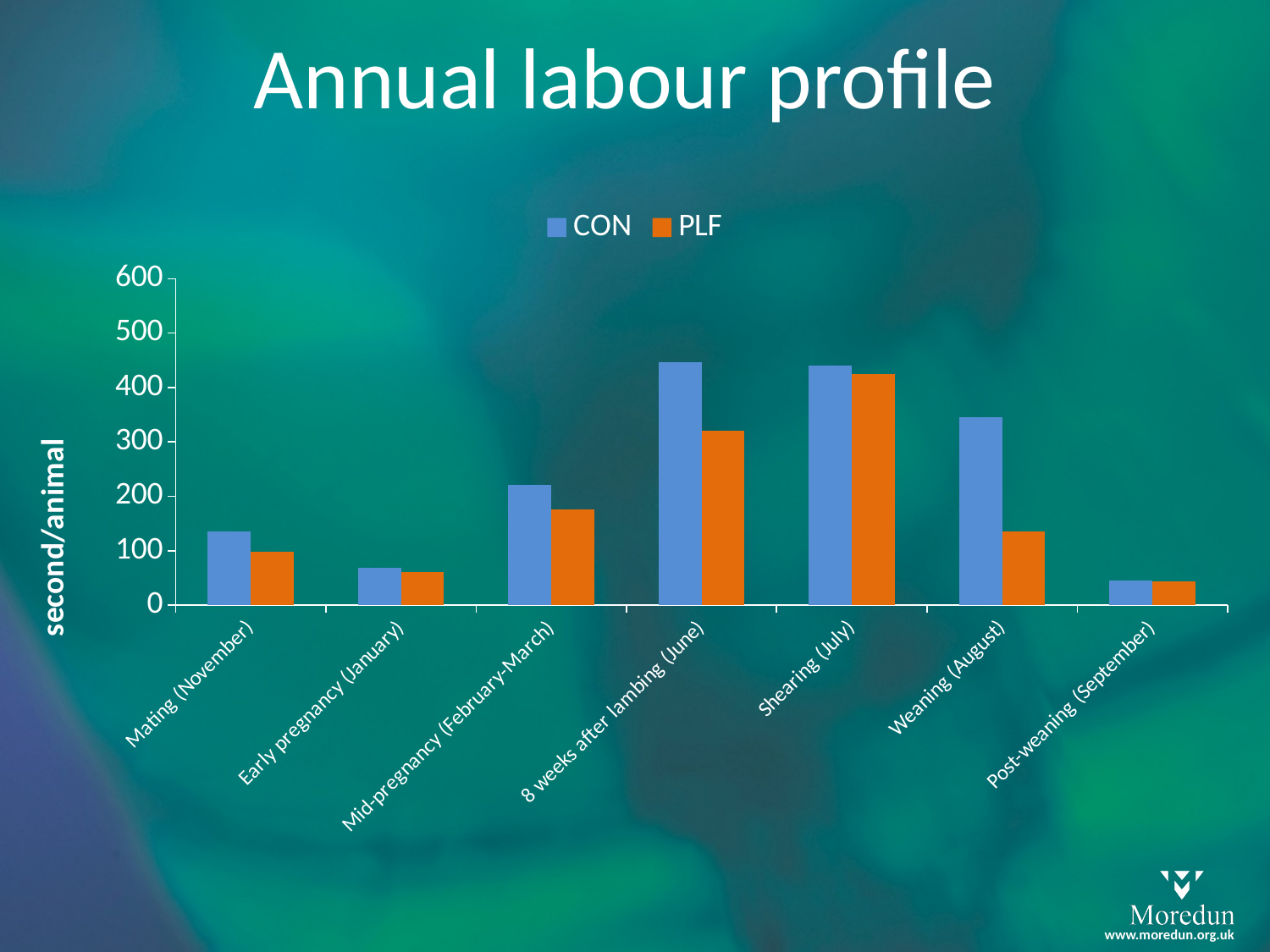
How many categories are shown on the x axis? 7 For which category is the PLF value lowest? Post-weaning (September) For which category is the PLF value highest? Shearing (July) Is the CON value for 8 weeks after lambing (June) greater or less than 400? greater Is the PLF value for 8 weeks after lambing (June) greater or less than 400? less What is the title of the chart? Annual labour profile At Weaning (August), which series has the larger value, CON or PLF? CON For which category is the CON value lowest? Post-weaning (September) What is the y-axis label of the chart? second/animal What kind of chart is shown on the slide? bar chart How many series does the legend list? 2 At 8 weeks after lambing (June), which series has the larger value, CON or PLF? CON